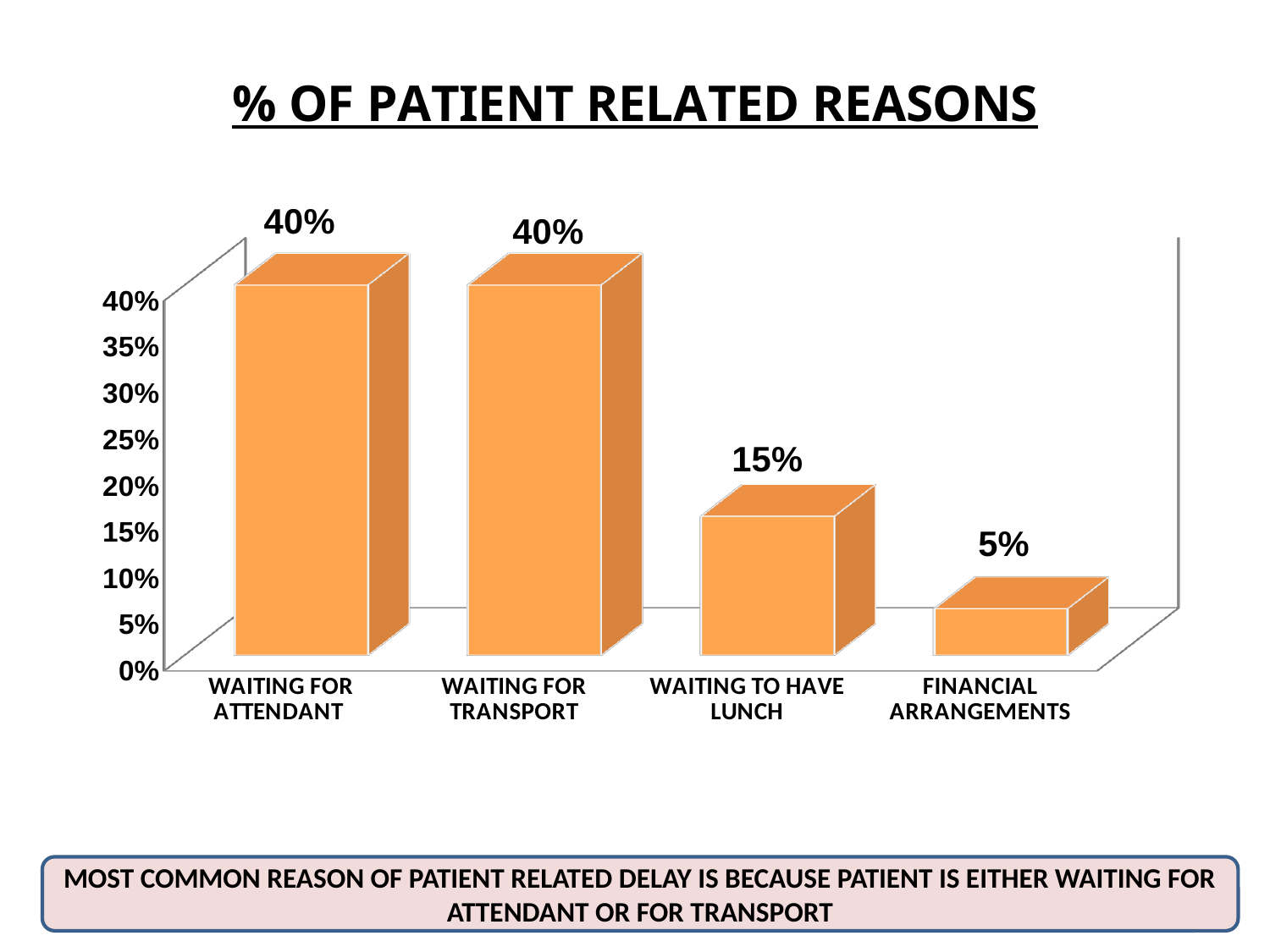
Is the value for WAITING TO HAVE LUNCH greater or less than 20%? less What is the value for FINANCIAL ARRANGEMENTS? 5% What is the value for WAITING FOR ATTENDANT? 40% Which is larger, the value for WAITING FOR ATTENDANT or the value for WAITING TO HAVE LUNCH? WAITING FOR ATTENDANT What is the value for WAITING TO HAVE LUNCH? 15% Which category has the lowest value? FINANCIAL ARRANGEMENTS What kind of chart is shown on the slide? bar chart What is the value for WAITING FOR TRANSPORT? 40% What is the difference between the values for WAITING FOR TRANSPORT and WAITING TO HAVE LUNCH? 25% What is the difference between the values for WAITING TO HAVE LUNCH and FINANCIAL ARRANGEMENTS? 10% How many categories are shown on the chart? 4 What is the title of the chart? % OF PATIENT RELATED REASONS